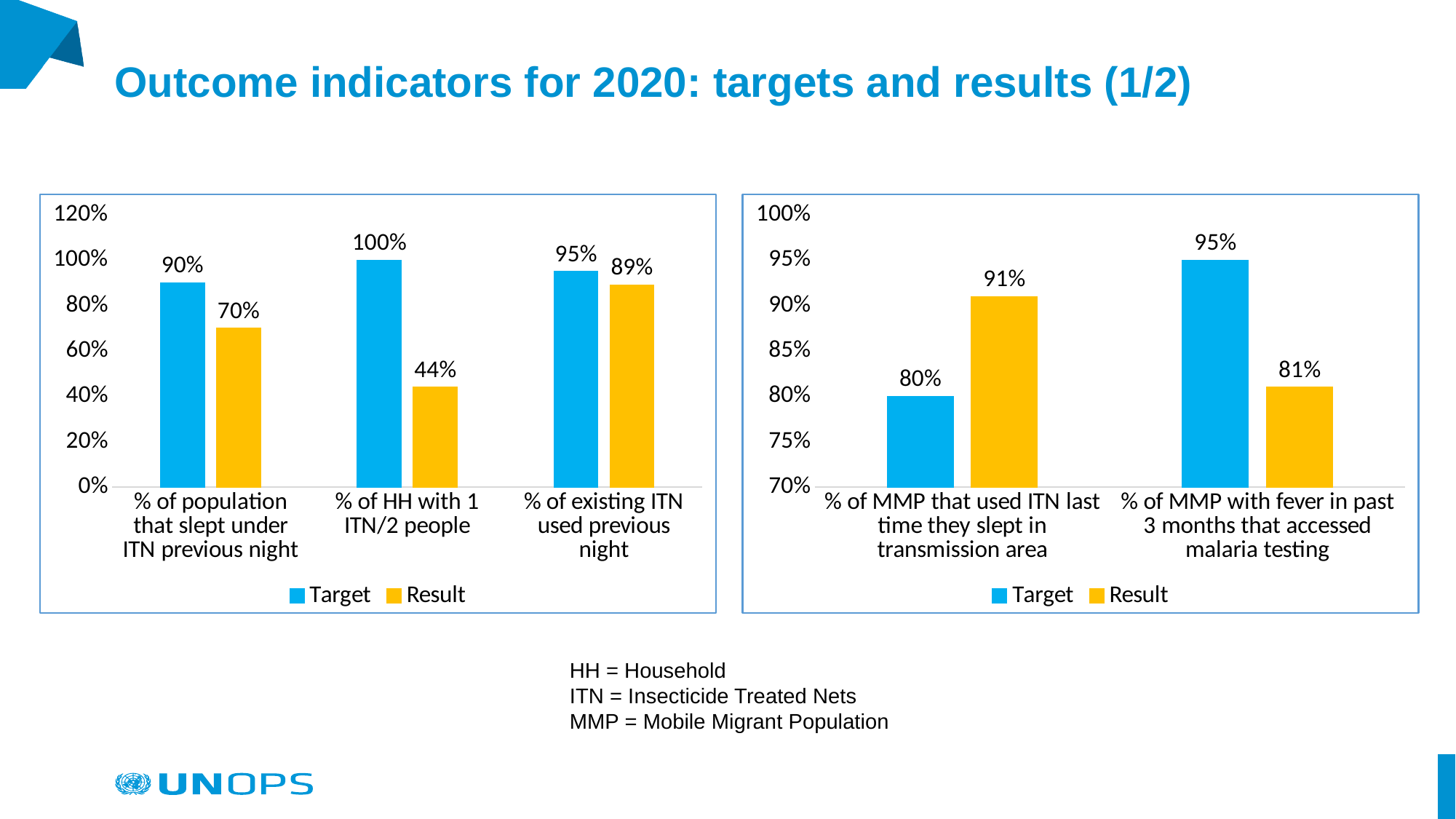
In the right chart, is the Target or the Result larger for '% of MMP with fever in past 3 months that accessed malaria testing'? Target What type of chart is the right chart? Bar chart In the left chart, which category has the lowest Result value? % of HH with 1 ITN/2 people In the right chart, what is the Target value for '% of MMP with fever in past 3 months that accessed malaria testing'? 95% In the left chart, what is the Target value for '% of population that slept under ITN previous night'? 90% How many categories are shown in the left chart? 3 In the left chart, what is the difference between the Target and Result for '% of existing ITN used previous night'? 6% In the left chart, what is the Result value for '% of HH with 1 ITN/2 people'? 44% In the right chart, what is the difference between the Result and Target for '% of MMP that used ITN last time they slept in transmission area'? 11% How many series does the legend of the right chart list? 2 In the left chart, which category has the highest Target value? % of HH with 1 ITN/2 people In the right chart, what is the Result value for '% of MMP that used ITN last time they slept in transmission area'? 91%